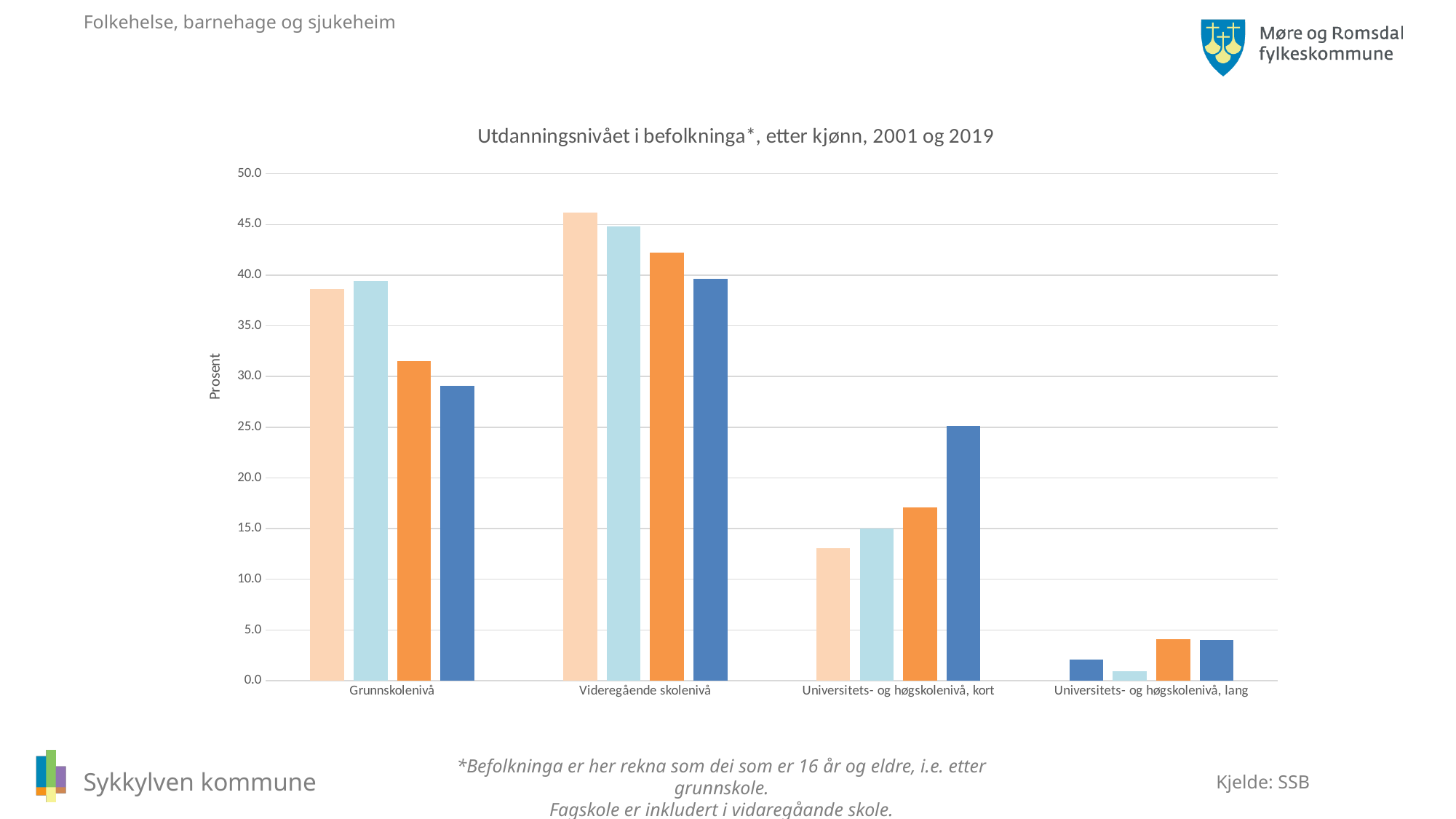
What is the label on the vertical axis? Prosent What is the title of the chart? Utdanningsnivået i befolkninga*, etter kjønn, 2001 og 2019 What kind of chart is shown on the slide? bar chart Which category has the shortest bars? Universitets- og høgskolenivå, lang Is the value of the light orange bar for Videregående skolenivå greater or less than 40.0? greater Is the value of the dark blue bar for Universitets- og høgskolenivå, kort greater or less than 20.0? greater Which category has the tallest bars? Videregående skolenivå Is the value of the dark blue bar for Grunnskolenivå greater or less than 35.0? less For Universitets- og høgskolenivå, kort, which is larger: the dark blue bar or the light orange bar? the dark blue bar How many bars are plotted for each category? 4 How many education-level categories are shown on the x axis? 4 For Universitets- og høgskolenivå, kort, do the bars rise or fall from left to right? rise